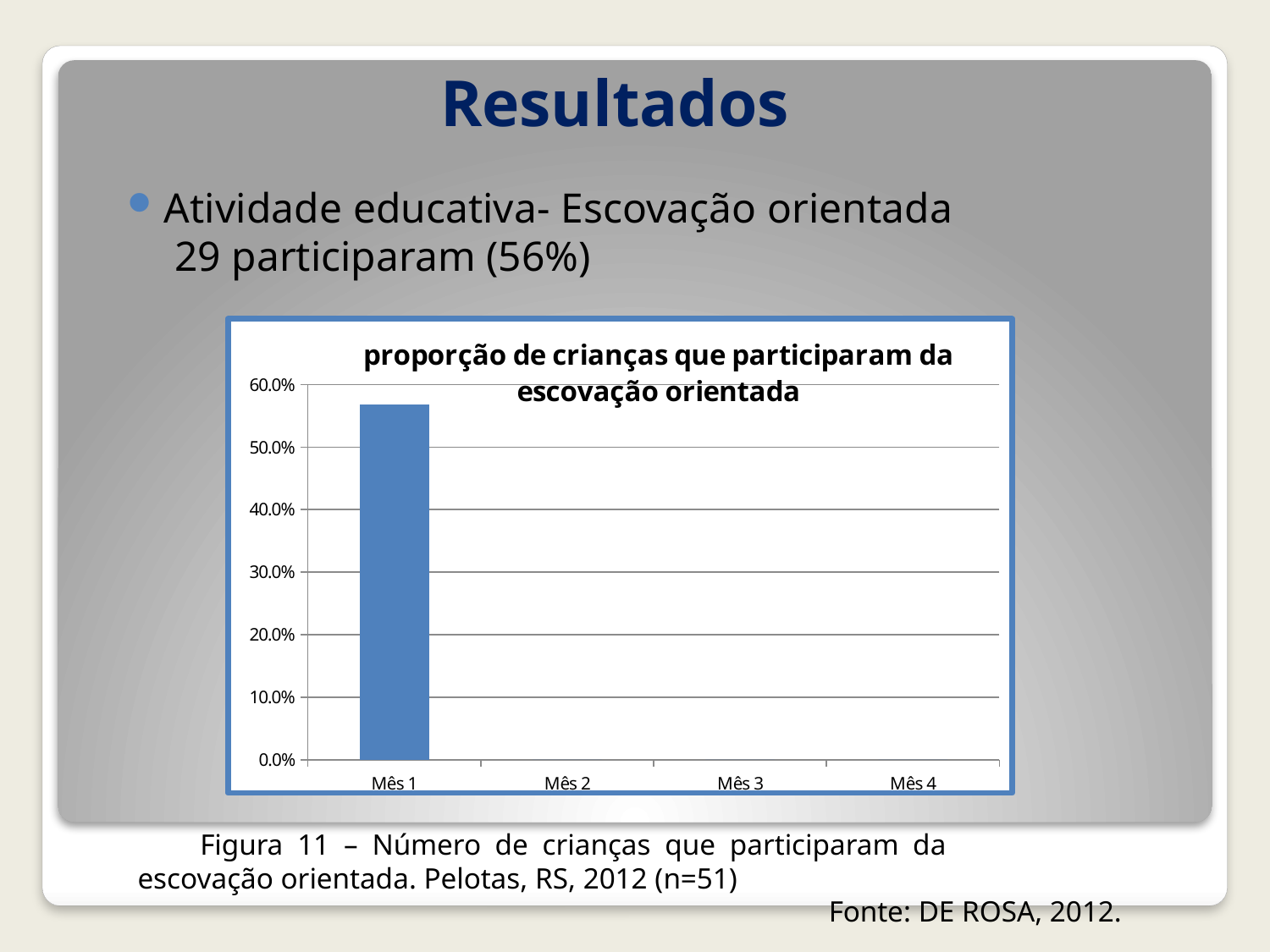
What is the title of the chart? proporção de crianças que participaram da escovação orientada Is the value for Mês 1 greater or less than 50.0%? greater Which is larger, the value for Mês 1 or the value for Mês 2? Mês 1 Is the value for Mês 1 greater or less than 60.0%? less What is the label of the last category on the x axis? Mês 4 Which category has the highest value in the chart? Mês 1 How many categories are shown on the x axis of the chart? 4 Which category is the only one with a visible bar in the chart? Mês 1 What kind of chart is shown on the slide? bar chart What is the highest tick value shown on the y axis of the chart? 60.0%